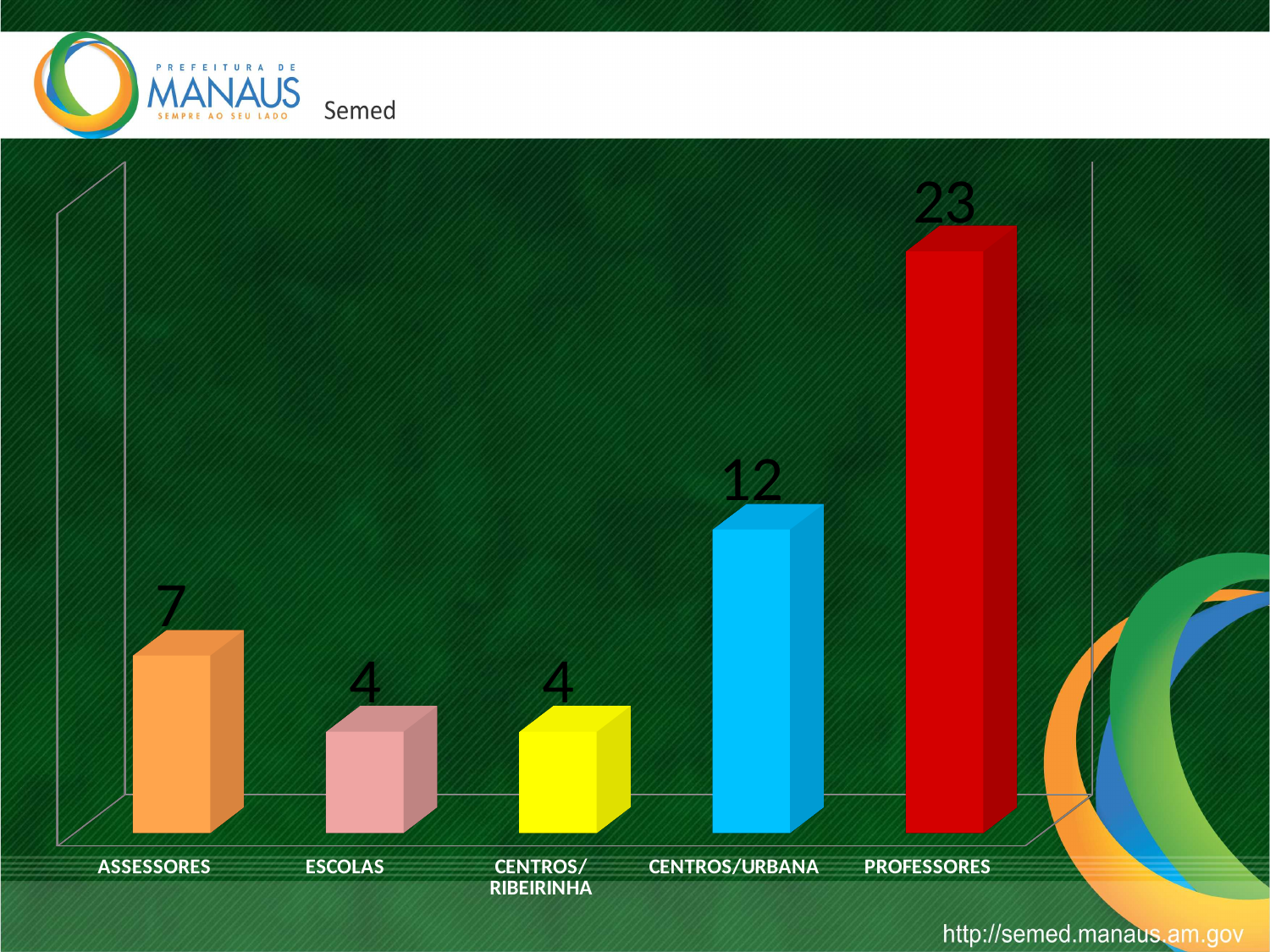
Which category has the highest value? PROFESSORES What is the difference between the values for ASSESSORES and ESCOLAS? 3 What kind of chart is shown on the slide? bar chart Do the values for ESCOLAS and CENTROS/RIBEIRINHA differ? No, both are 4 What is the difference between the values for PROFESSORES and CENTROS/URBANA? 11 What colour is the bar for PROFESSORES? red What is the value for CENTROS/URBANA? 12 Which is larger, the value for CENTROS/URBANA or the value for ASSESSORES? CENTROS/URBANA What is the value for ASSESSORES? 7 What is the value for ESCOLAS? 4 What is the value for PROFESSORES? 23 How many categories are shown in the chart? 5